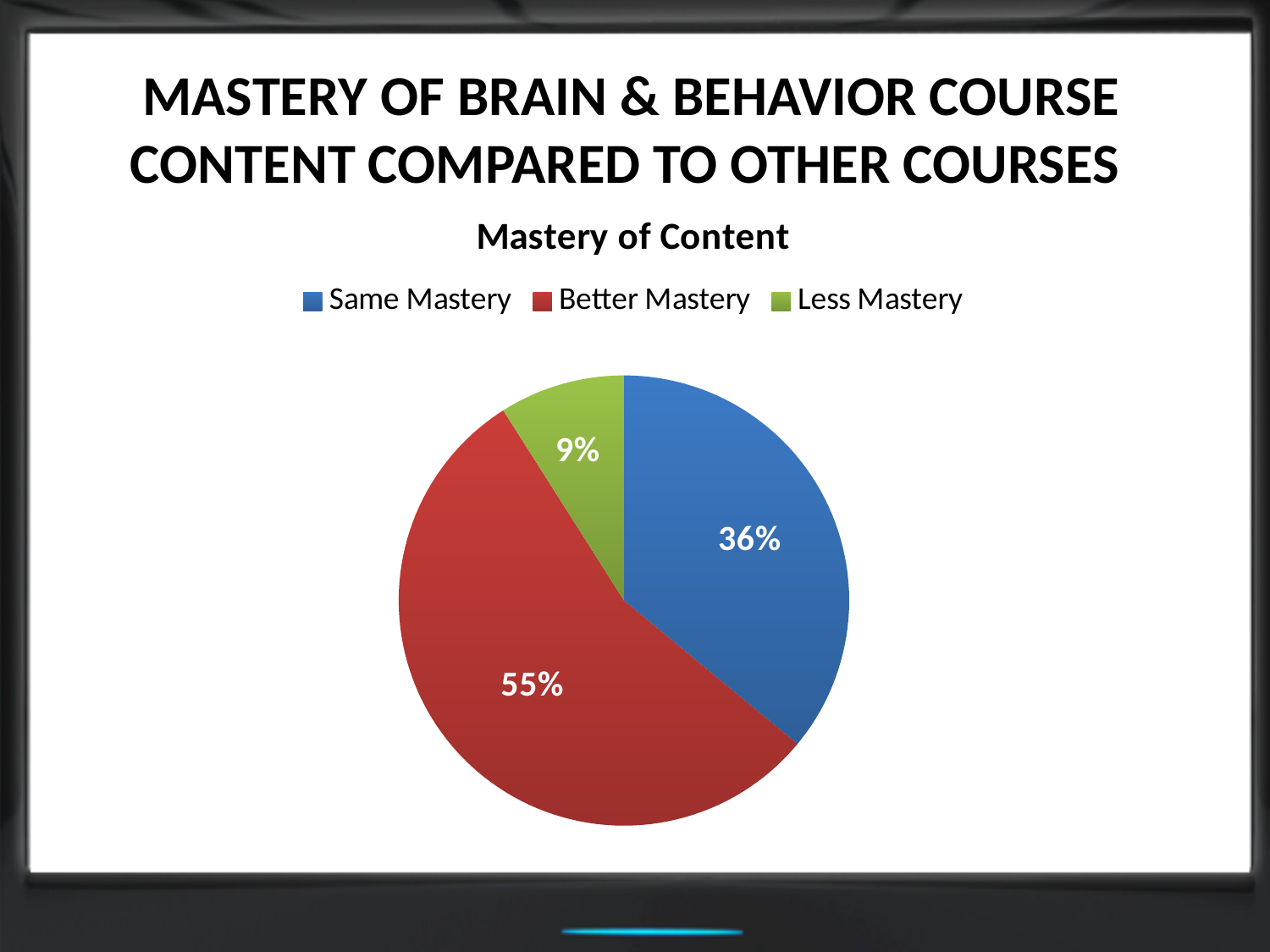
What share of the pie does Better Mastery represent? 55% What share of the pie does Same Mastery represent? 36% Which category has the smallest slice of the pie? Less Mastery What colour is the Better Mastery slice? Red Which is larger, the Same Mastery slice or the Less Mastery slice? Same Mastery Which category has the largest slice of the pie? Better Mastery What is the difference in percentage points between Better Mastery and Same Mastery? 19 What share of the pie does Less Mastery represent? 9% What is the title of the chart? Mastery of Content What is the difference in percentage points between Same Mastery and Less Mastery? 27 How many categories are shown in the pie chart? 3 What kind of chart is shown on the slide? Pie chart